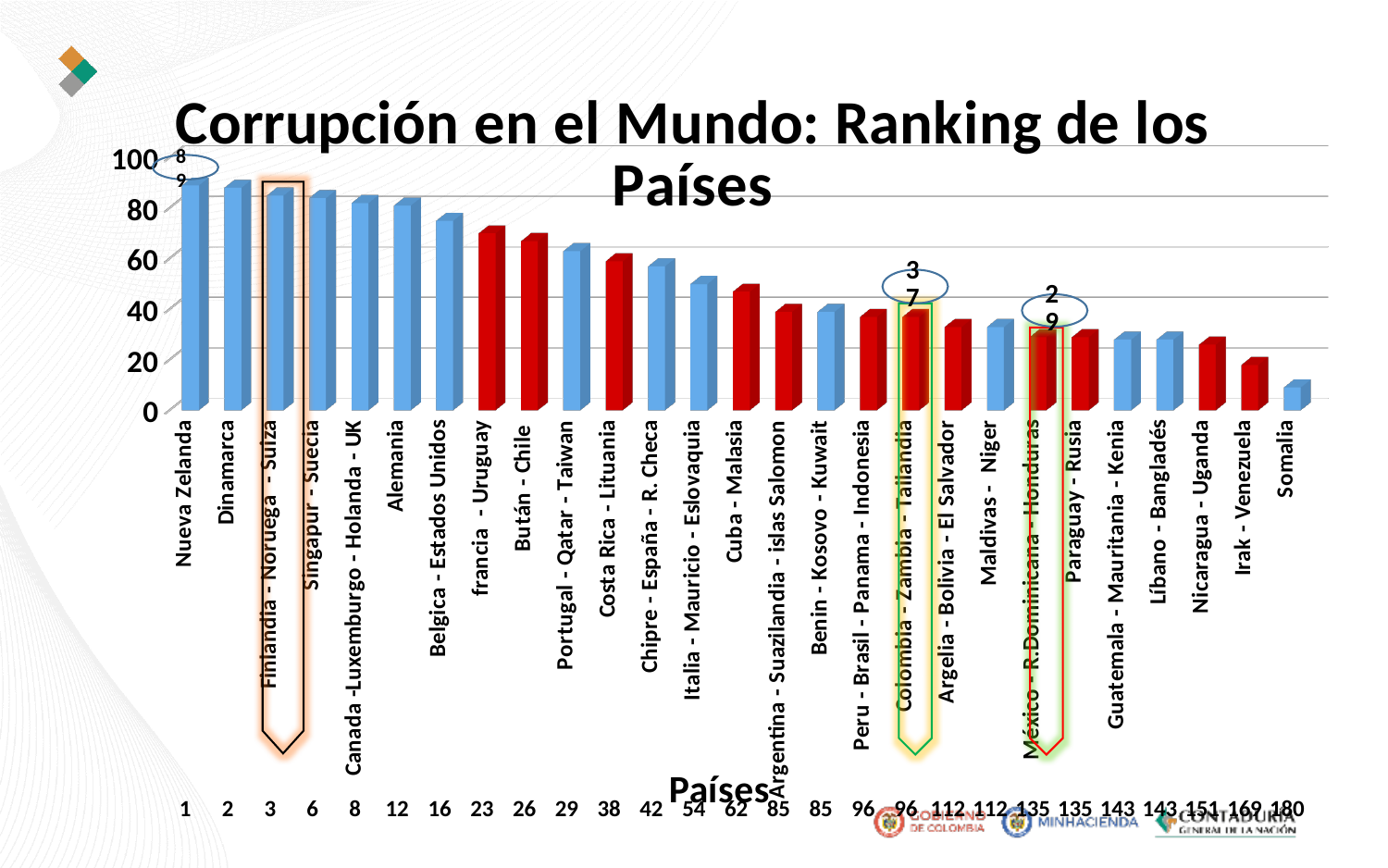
What value is labelled for México - R.Dominicana - Honduras? 29 What value is labelled for Colombia - Zambia - Tailandia? 37 Which category has the lowest bar? Somalia Is the value for Dinamarca greater or less than 80? greater What is the difference between the labelled values for Nueva Zelanda and Colombia - Zambia - Tailandia? 52 Which category has the highest bar? Nueva Zelanda Which is larger, the value for Dinamarca or the value for Irak - Venezuela? Dinamarca Is the value for Somalia greater or less than 20? less What value is labelled for Nueva Zelanda? 89 What kind of chart is shown on the slide? bar chart What is the title of the chart? Corrupción en el Mundo: Ranking de los Países Do the bar values generally rise or fall from left to right along the x axis? fall